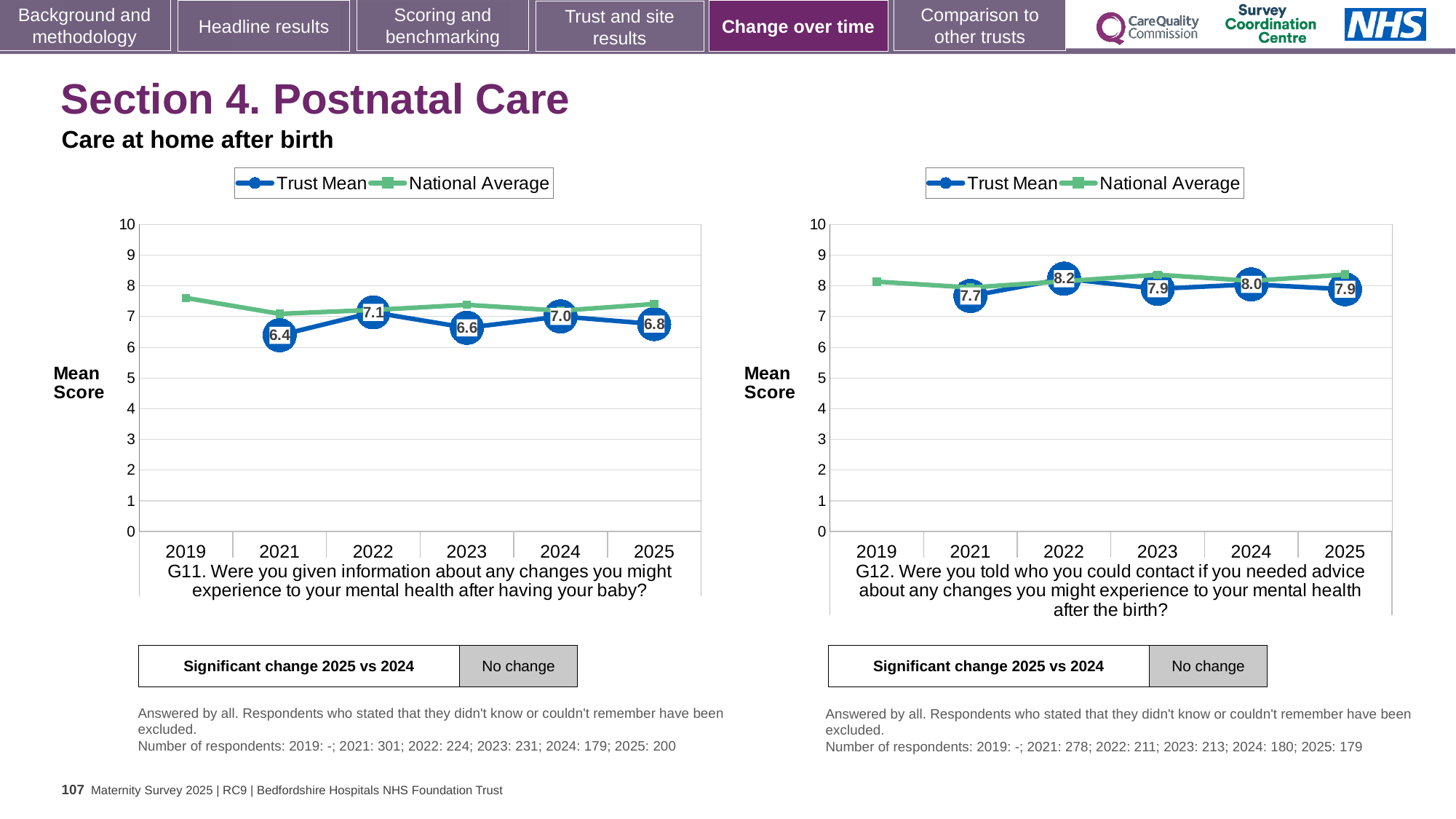
What type of chart is the G11 chart (left)? Line chart In the G11 chart (left), which year has the lowest Trust Mean? 2021 In the G11 chart (left), what is the difference between the Trust Mean in 2022 and in 2021? 0.7 In the G12 chart (right), which year has the highest Trust Mean? 2022 In the G12 chart (right), is the Trust Mean for 2024 larger than the Trust Mean for 2021? Yes, 2024 (8.0) is larger than 2021 (7.7) In the G11 chart (left), what is the Trust Mean for 2022? 7.1 In the G11 chart (left), is the Trust Mean for 2021 greater or less than 7? less In the G12 chart (right), what is the Trust Mean for 2021? 7.7 In the G11 chart (left), what is the Trust Mean for 2025? 6.8 How many years are shown on the x axis of the G11 chart (left)? 6 How many series does the legend of the G12 chart (right) list? 2 In the G12 chart (right), what is the difference between the Trust Mean in 2022 and in 2025? 0.3